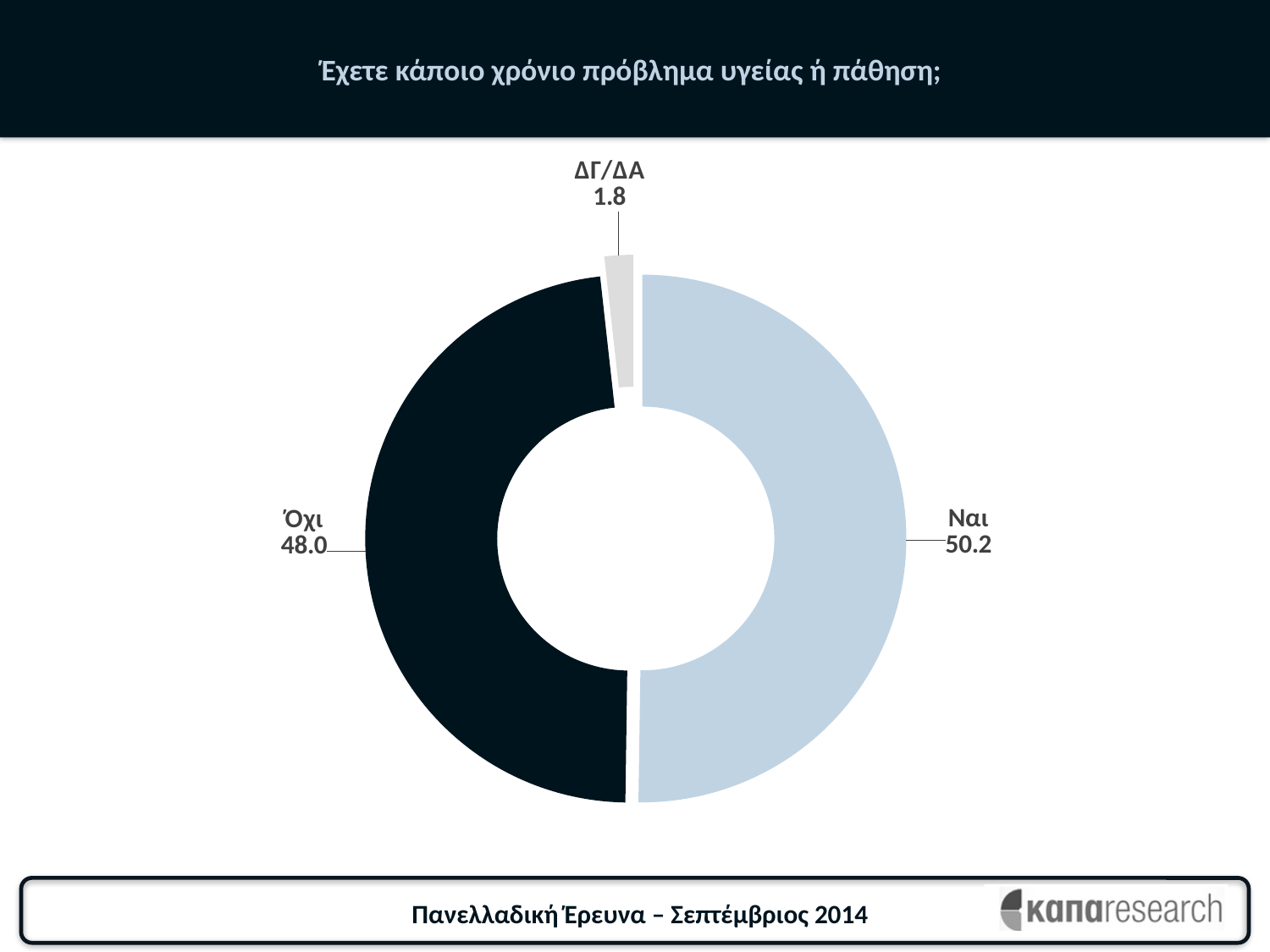
Which category has the smallest slice? ΔΓ/ΔΑ Which category has the largest slice? Ναι What is the value shown for ΔΓ/ΔΑ? 1.8 Which category is shown in the light blue slice? Ναι What is the difference between the values for Ναι and Όχι? 2.2 What is the value shown for Ναι? 50.2 What is the value shown for Όχι? 48.0 What kind of chart is shown on the slide? pie chart (doughnut) What is the title of the chart? Έχετε κάποιο χρόνιο πρόβλημα υγείας ή πάθηση; Which is larger, the value for Ναι or the value for Όχι? Ναι What is the total of the three values shown in the chart? 100.0 How many categories are shown in the chart? 3